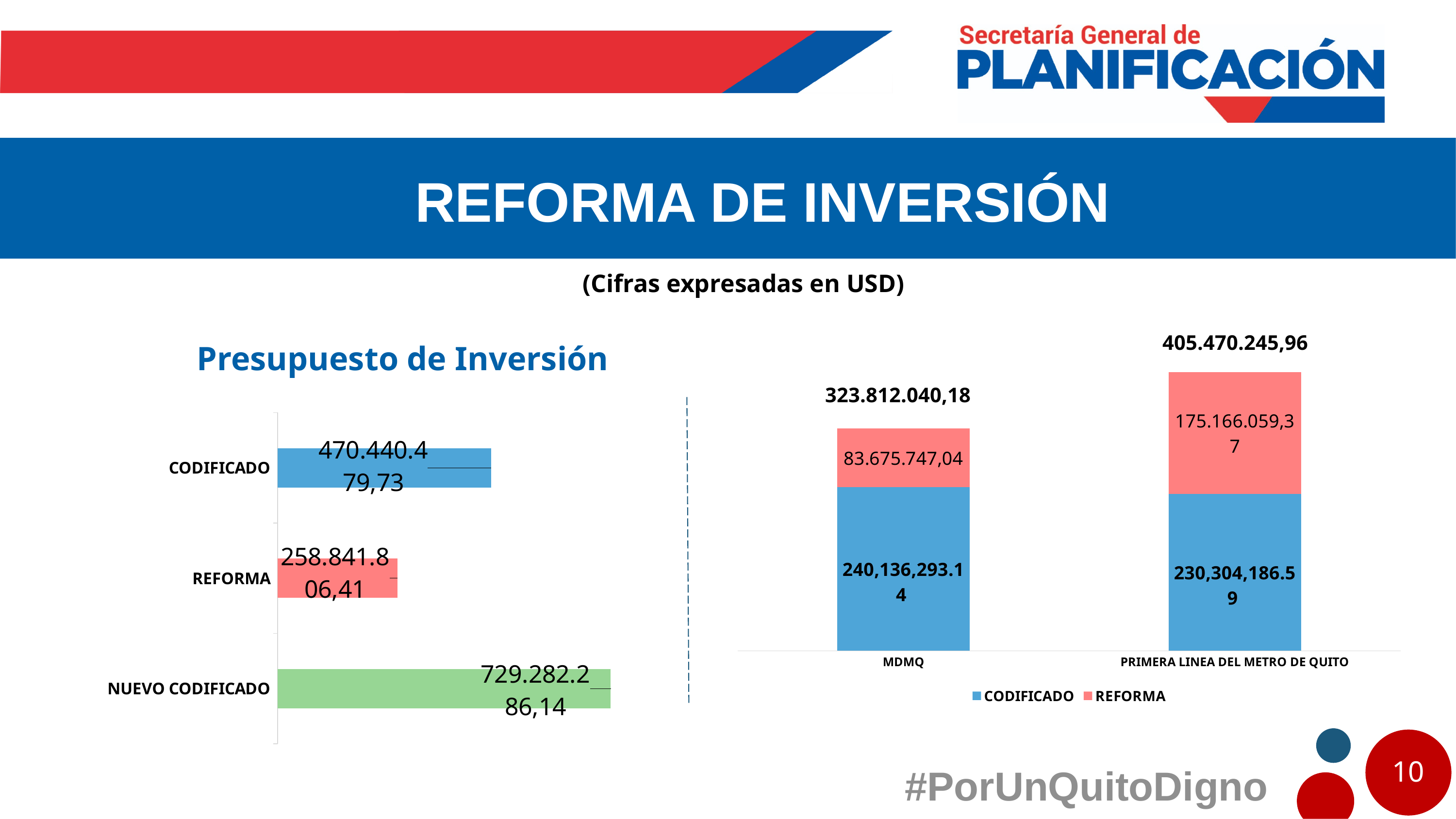
In the 'Presupuesto de Inversión' chart on the left, what is the value for NUEVO CODIFICADO? 729.282.286,14 In the 'Presupuesto de Inversión' chart on the left, what is the value for REFORMA? 258.841.806,41 In the 'Presupuesto de Inversión' chart on the left, what is the value for CODIFICADO? 470.440.479,73 In the stacked bar chart on the right, what is the REFORMA value for PRIMERA LINEA DEL METRO DE QUITO? 175.166.059,37 In the stacked bar chart on the right, what is the CODIFICADO value for MDMQ? 240,136,293.14 In the stacked bar chart on the right, what is the total of the MDMQ bar? 323.812.040,18 In the 'Presupuesto de Inversión' chart on the left, which category has the lowest value? REFORMA In the 'Presupuesto de Inversión' chart on the left, which category has the highest value? NUEVO CODIFICADO In the 'Presupuesto de Inversión' chart on the left, what is the difference between NUEVO CODIFICADO and CODIFICADO? 258.841.806,41 How many series does the legend of the stacked bar chart on the right list? 2 What kind of chart is the 'Presupuesto de Inversión' chart on the left? Bar chart In the stacked bar chart on the right, which category has the larger REFORMA value, MDMQ or PRIMERA LINEA DEL METRO DE QUITO? PRIMERA LINEA DEL METRO DE QUITO